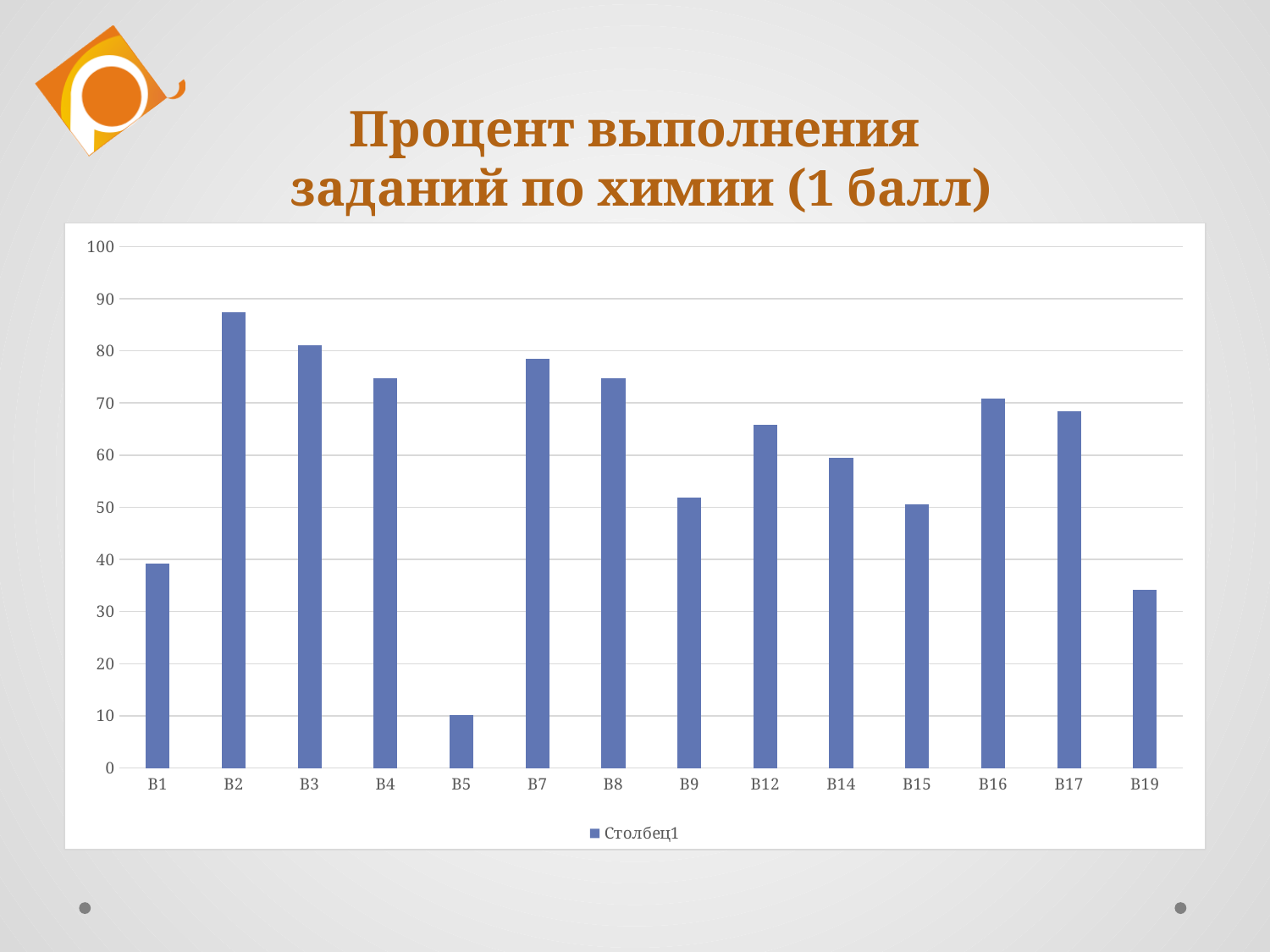
Is the value for B5 greater or less than 20? less Is the value for B19 greater or less than 40? less Which category has the lowest value in the chart? B5 How many categories are shown on the x axis of the chart? 14 What is the name of the series shown in the chart legend? Столбец1 Which is larger, the value for B3 or the value for B4? B3 Which category has the highest value in the chart? B2 Is the value for B12 greater or less than 60? greater Which is larger, the value for B9 or the value for B14? B14 How many series does the chart legend list? 1 What kind of chart is shown on the slide? Bar chart